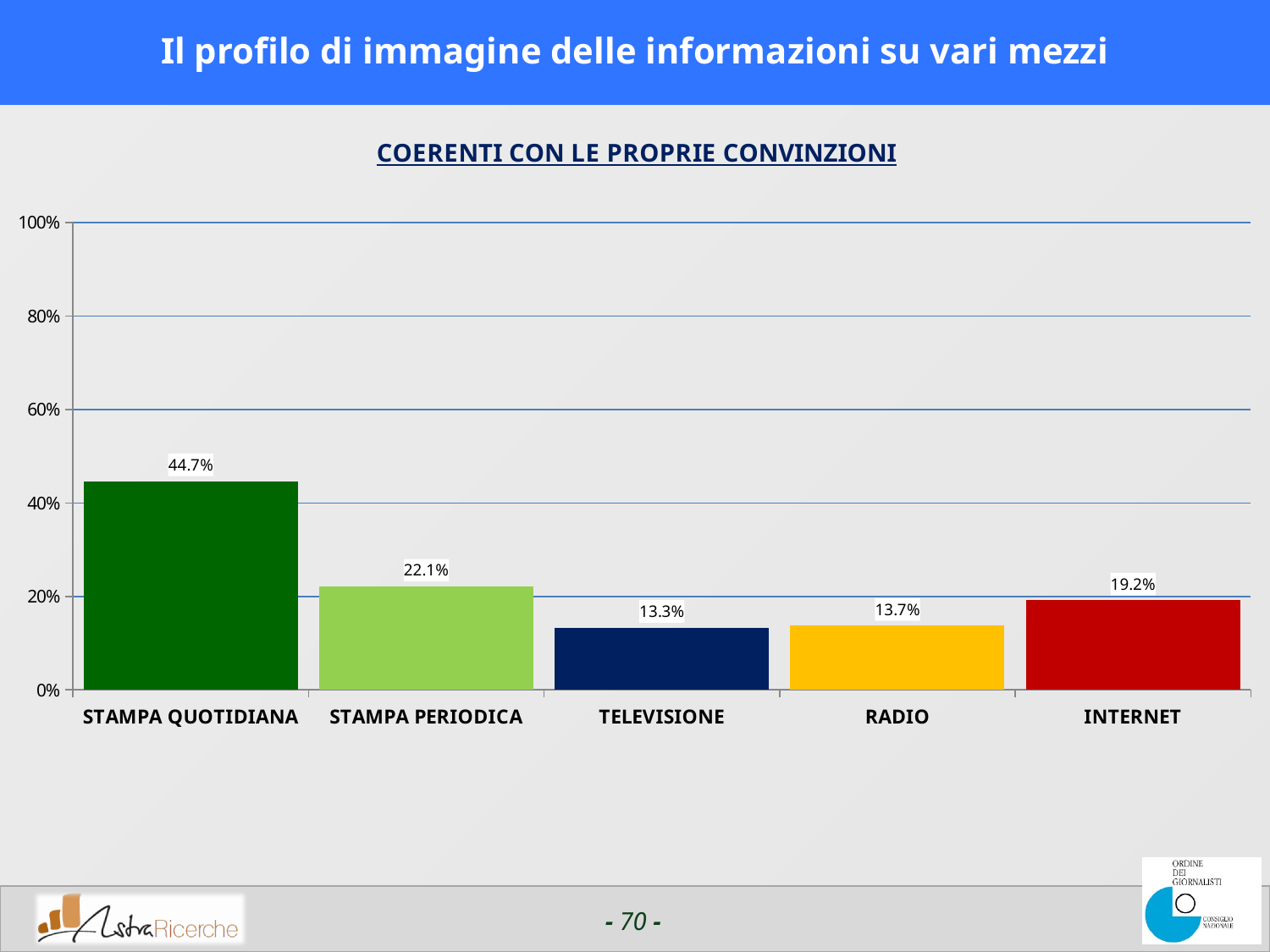
Which category has the lowest value? TELEVISIONE What is the difference between the values for RADIO and TELEVISIONE? 0.4% What is the value for TELEVISIONE? 13.3% Which is larger, the value for INTERNET or the value for RADIO? INTERNET Which category has the highest value? STAMPA QUOTIDIANA Is the value for STAMPA QUOTIDIANA greater or less than 40%? greater What kind of chart is shown on the slide? bar chart What is the title of the chart? COERENTI CON LE PROPRIE CONVINZIONI How many categories are shown on the x axis? 5 What is the value for STAMPA QUOTIDIANA? 44.7% What is the value for INTERNET? 19.2% What is the difference between the values for STAMPA QUOTIDIANA and STAMPA PERIODICA? 22.6%